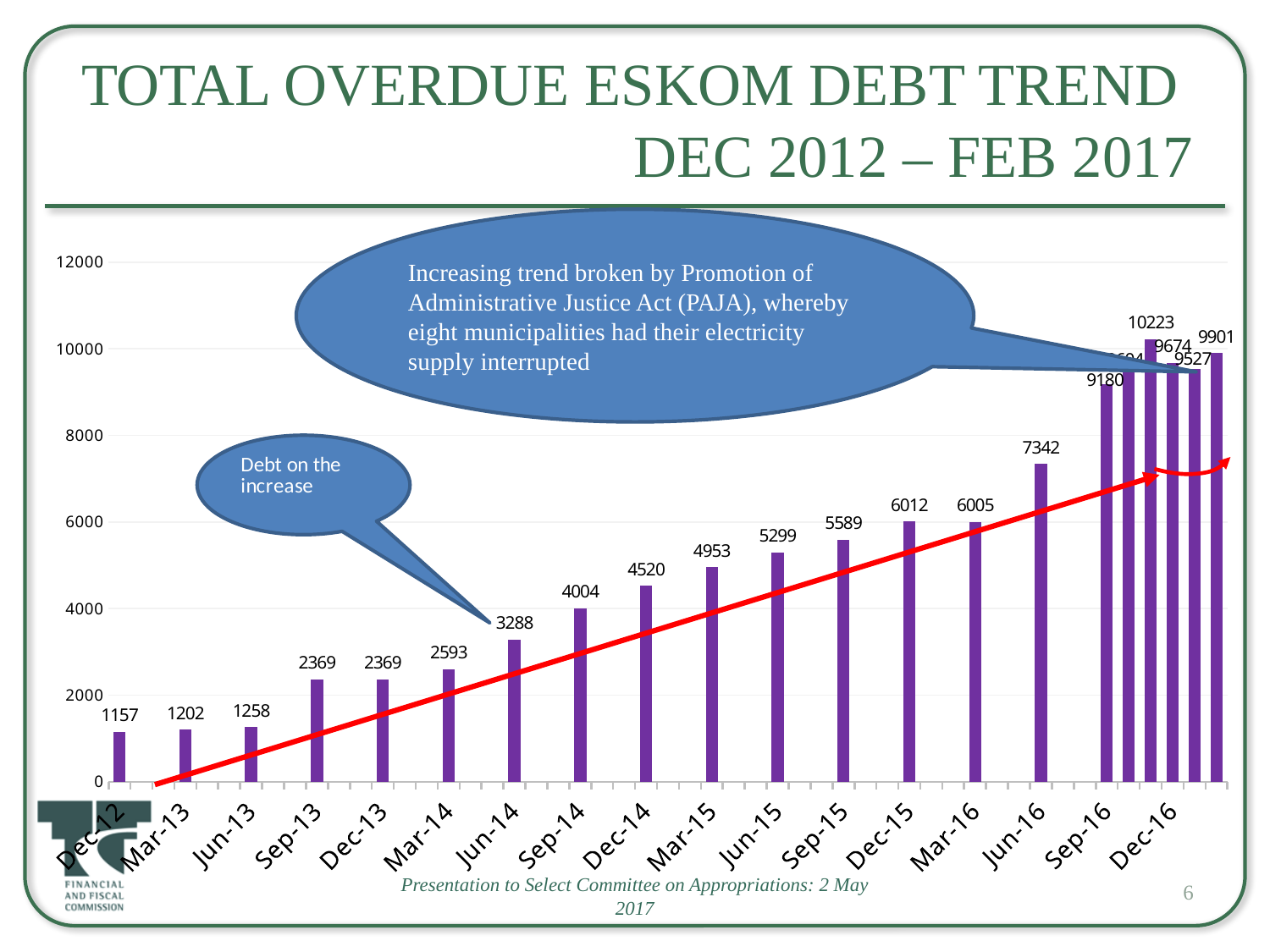
What value is labelled on the bar for Jun-16? 7342 By how much did the value increase from Mar-16 to Jun-16? 1337 What is the total overdue Eskom debt value shown for Dec-12? 1157 Is the value for Dec-14 greater or less than 4000? greater Do the values generally rise or fall from Dec-12 to Jun-16? Rise What is the difference between the values for Sep-13 and Dec-13? 0 What is the highest data label value shown on the chart? 10223 What type of chart is used on this slide? Bar chart Which period has the lowest overdue debt value? Dec-12 What is the value shown for Mar-15? 4953 Which is larger, the value for Dec-15 or the value for Mar-16? Dec-15 What is the value shown for Sep-14? 4004